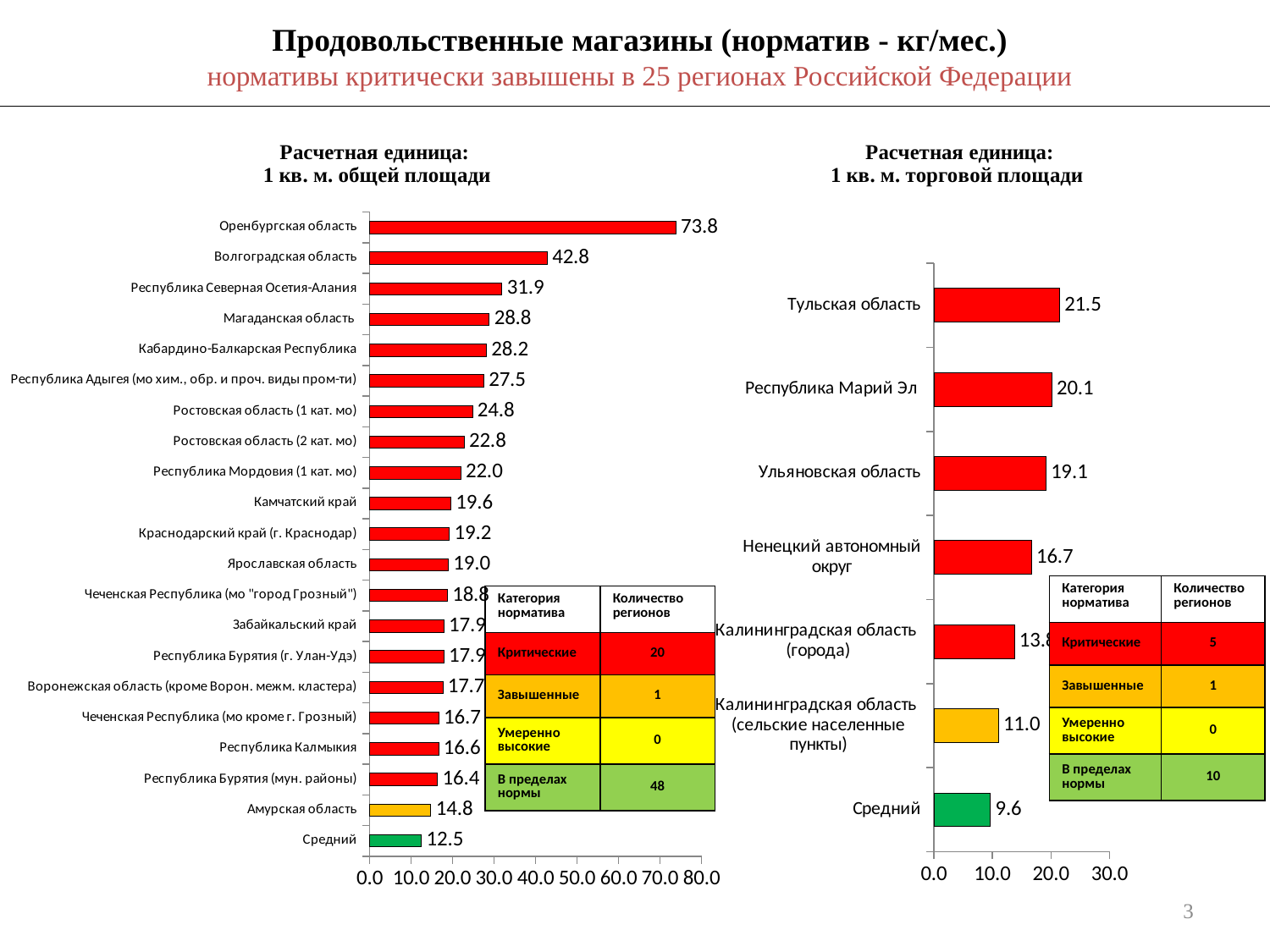
On the left chart (1 кв. м. общей площади), what is the value for Амурская область? 14.8 What type of chart is the right chart (1 кв. м. торговой площади)? Bar chart On the right chart (1 кв. м. торговой площади), how many bars are plotted? 7 On the left chart (1 кв. м. общей площади), what is the value for Оренбургская область? 73.8 On the right chart (1 кв. м. торговой площади), which is larger: Республика Марий Эл or Ульяновская область? Республика Марий Эл On the left chart (1 кв. м. общей площади), how many bars are plotted? 21 On the right chart (1 кв. м. торговой площади), is the value for Ненецкий автономный округ greater or less than 20.0? less On the right chart (1 кв. м. торговой площади), what is the value for Тульская область? 21.5 On the left chart (1 кв. м. общей площади), what is the difference between Оренбургская область and Волгоградская область? 31.0 On the left chart (1 кв. м. общей площади), which category has the highest value? Оренбургская область On the right chart (1 кв. м. торговой площади), which category has the lowest value? Средний On the left chart (1 кв. м. общей площади), which category has the lowest value? Средний